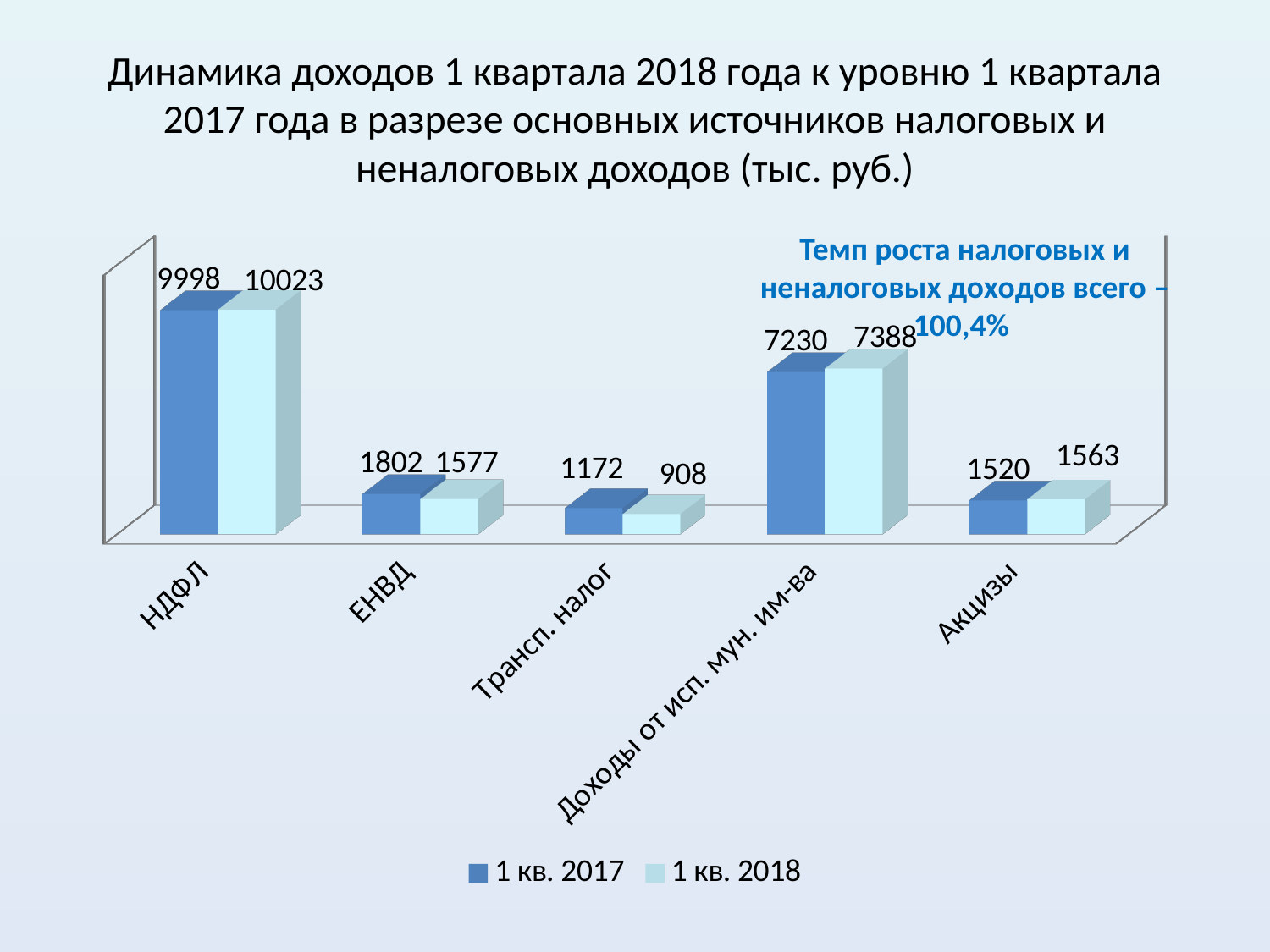
Which is larger for Акцизы: the 1 кв. 2017 value or the 1 кв. 2018 value? 1 кв. 2018 What is the difference between the 1 кв. 2018 and 1 кв. 2017 values for Доходы от исп. мун. им-ва? 158 How many series does the legend list? 2 What is the value for НДФЛ in the 1 кв. 2017 series? 9998 What kind of chart is shown on the slide? Bar chart What is the value for Акцизы in the 1 кв. 2017 series? 1520 Which category has the highest value in the 1 кв. 2018 series? НДФЛ What is the difference between the 1 кв. 2017 and 1 кв. 2018 values for ЕНВД? 225 Which category has the lowest value in the 1 кв. 2017 series? Трансп. налог How many categories are shown on the x axis? 5 What is the value for Трансп. налог in the 1 кв. 2018 series? 908 What is the value for НДФЛ in the 1 кв. 2018 series? 10023